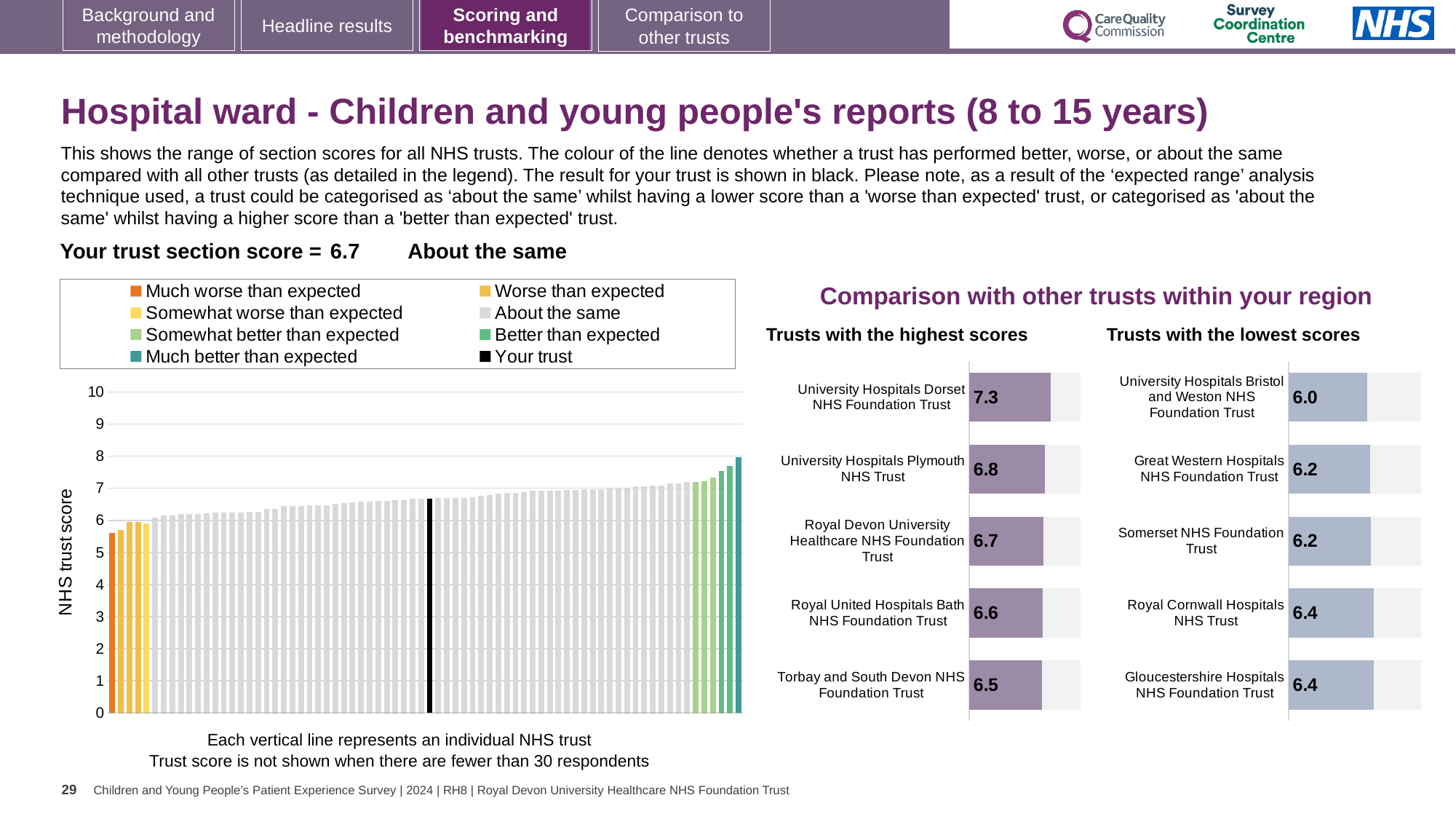
In the 'Trusts with the highest scores' chart, what is the score for University Hospitals Dorset NHS Foundation Trust? 7.3 In the 'Trusts with the highest scores' chart, which trust has the highest score? University Hospitals Dorset NHS Foundation Trust How many trusts are shown in the 'Trusts with the highest scores' chart? 5 In the 'Trusts with the highest scores' chart, what is the score for Torbay and South Devon NHS Foundation Trust? 6.5 How many entries does the legend above the 'NHS trust score' chart list? 8 In the 'NHS trust score' bar chart on the left, is the value of the black bar (your trust) greater or less than 6? greater In the 'Trusts with the lowest scores' chart, what is the score for Great Western Hospitals NHS Foundation Trust? 6.2 Comparing the 'Trusts with the highest scores' and 'Trusts with the lowest scores' charts, which has the larger score: Royal United Hospitals Bath NHS Foundation Trust or Royal Cornwall Hospitals NHS Trust? Royal United Hospitals Bath NHS Foundation Trust In the 'Trusts with the highest scores' chart, what is the difference between the scores of University Hospitals Dorset NHS Foundation Trust and University Hospitals Plymouth NHS Trust? 0.5 In the 'Trusts with the lowest scores' chart, what is the difference between the scores of Royal Cornwall Hospitals NHS Trust and University Hospitals Bristol and Weston NHS Foundation Trust? 0.4 What kind of chart is the 'NHS trust score' chart on the left of the slide? bar chart In the 'Trusts with the lowest scores' chart, which trust has the lowest score? University Hospitals Bristol and Weston NHS Foundation Trust